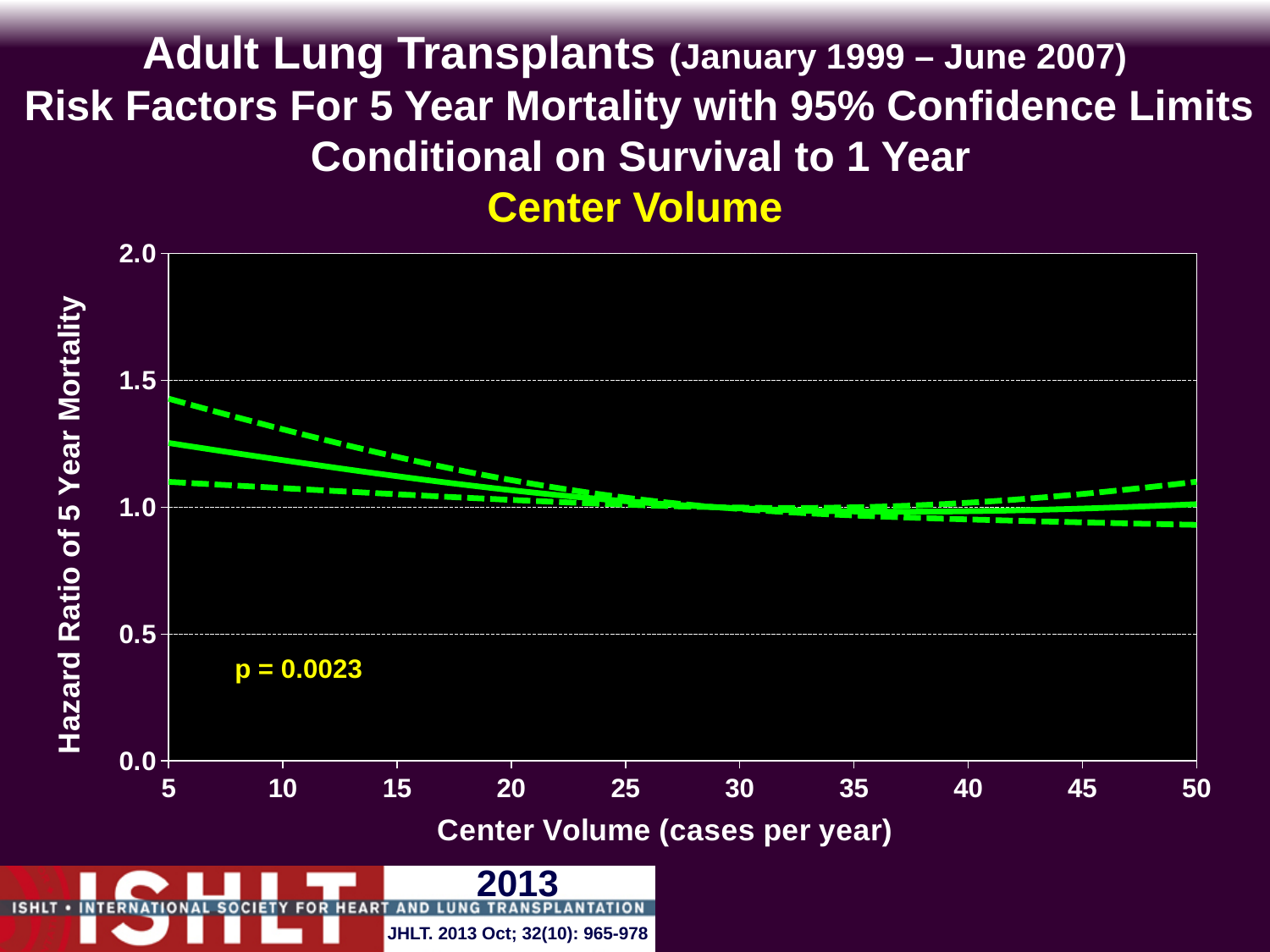
What kind of chart is shown on the slide? line chart Is the hazard ratio (solid line) at a center volume of 5 cases per year greater or less than 1.0? greater What p-value is printed on the chart? p = 0.0023 At which center volume does the solid hazard ratio line reach its highest value, 5 or 30 cases per year? 5 Does the solid hazard ratio line rise or fall as center volume increases from 5 to 30 cases per year? fall What is the label of the x axis? Center Volume (cases per year) Is the lower 95% confidence limit (lower dashed line) at a center volume of 50 cases per year greater or less than 1.0? less Is the hazard ratio (solid line) at a center volume of 10 cases per year greater or less than 1.5? less How many lines are plotted on the chart? 3